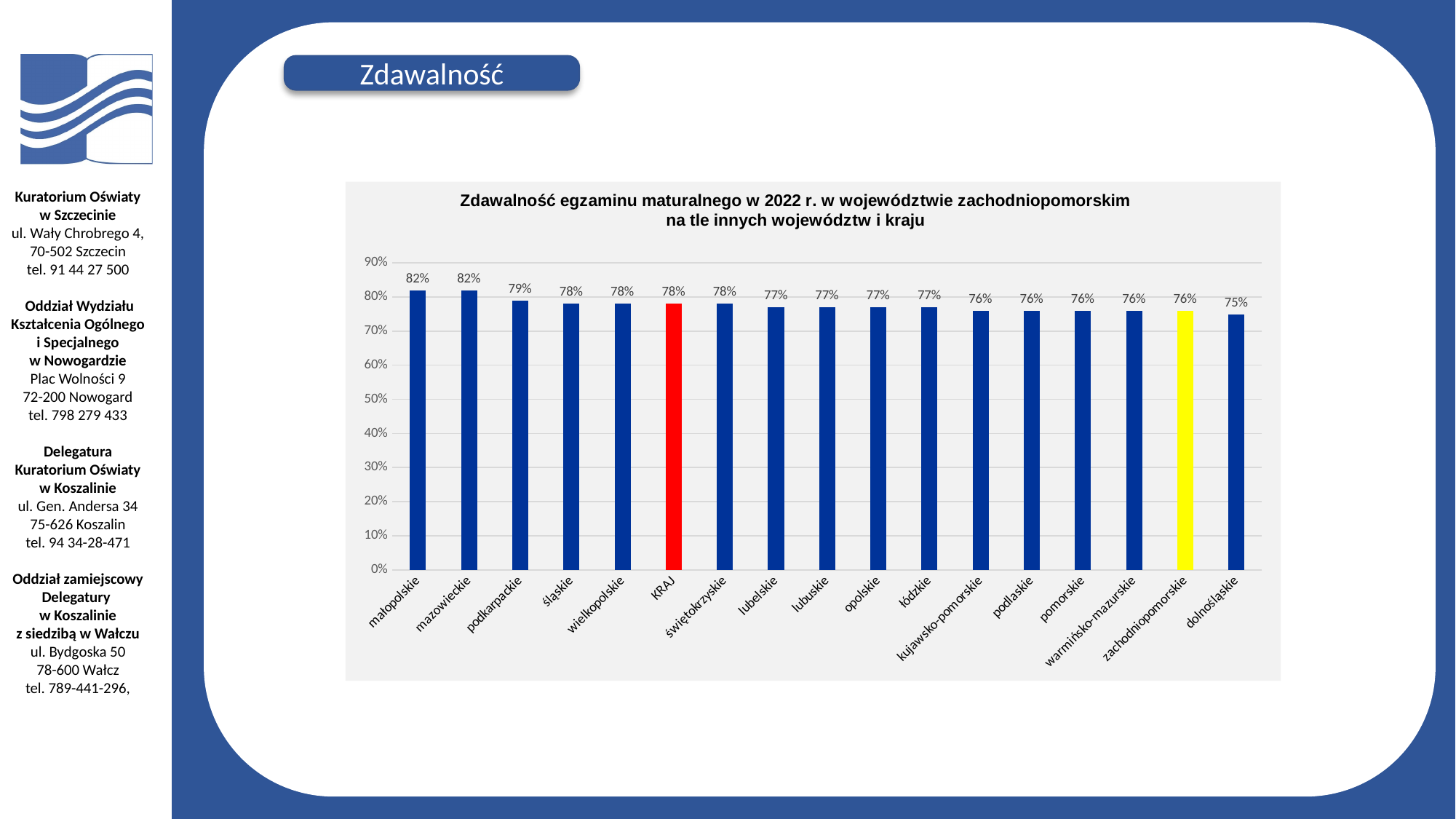
What colour is the bar for zachodniopomorskie? yellow What is the value for podkarpackie? 79% How many categories are shown on the x axis? 17 What is the difference between the values for małopolskie and dolnośląskie? 7 percentage points What is the difference between the values for KRAJ and zachodniopomorskie? 2 percentage points Is the value for lubuskie greater or less than 80%? less Which is larger, the value for podkarpackie or the value for lubelskie? podkarpackie What is the value for zachodniopomorskie? 76% What kind of chart is shown on the slide? bar chart Which category has the lowest value? dolnośląskie What is the value for KRAJ? 78% Do the values rise or fall from left to right along the x axis? fall